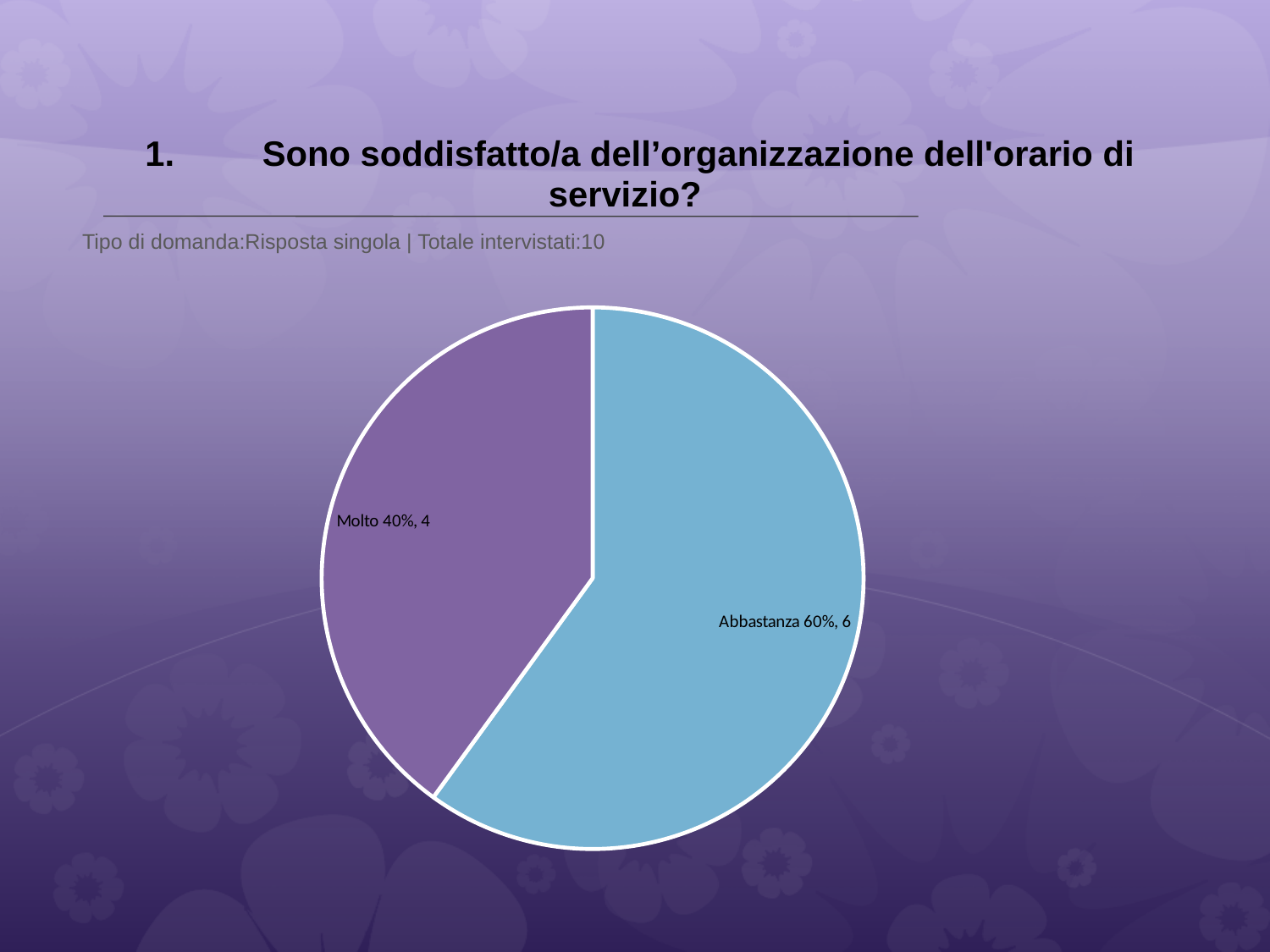
Which has more respondents, 'Molto' or 'Abbastanza'? Abbastanza What percentage share does the 'Molto' slice have? 40% What is the total number of respondents across both slices? 10 What colour is the 'Molto' slice? purple What is the difference in respondent count between 'Abbastanza' and 'Molto'? 2 How many respondents answered 'Molto'? 4 Which slice is the smallest in the pie chart? Molto What kind of chart is shown on the slide? pie chart How many slices does the pie chart have? 2 What percentage share does the 'Abbastanza' slice have? 60% How many respondents answered 'Abbastanza'? 6 Which slice is the largest in the pie chart? Abbastanza